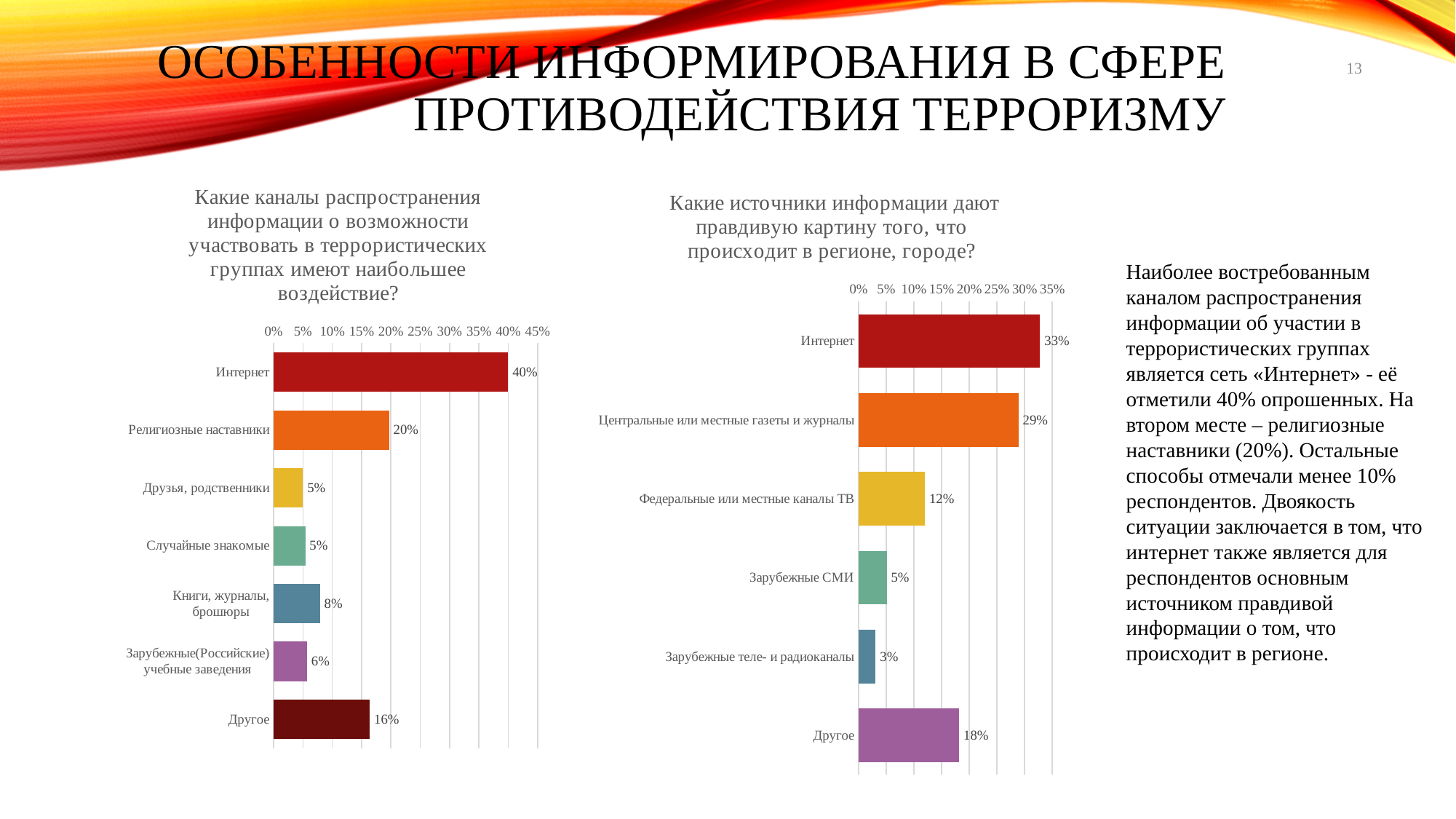
In the left chart (Какие каналы распространения информации...), what is the value for Интернет? 40% In the left chart (Какие каналы распространения информации...), what is the value for Религиозные наставники? 20% In the left chart (Какие каналы распространения информации...), which category has the lowest value? Друзья, родственники and Случайные знакомые (both 5%) What type of chart is used for the right chart (Какие источники информации дают правдивую картину...)? Bar chart In the right chart (Какие источники информации дают правдивую картину...), what is the difference between Федеральные или местные каналы ТВ and Зарубежные СМИ? 7% In the left chart (Какие каналы распространения информации...), what is the difference between Интернет and Другое? 24% In the right chart (Какие источники информации дают правдивую картину...), how many categories are shown? 6 In the left chart (Какие каналы распространения информации...), which is larger: Книги, журналы, брошюры or Зарубежные(Российские) учебные заведения? Книги, журналы, брошюры In the right chart (Какие источники информации дают правдивую картину...), what is the value for Центральные или местные газеты и журналы? 29% In the left chart (Какие каналы распространения информации...), how many categories are shown? 7 In the right chart (Какие источники информации дают правдивую картину...), which category has the highest value? Интернет In the right chart (Какие источники информации дают правдивую картину...), which category has the lowest value? Зарубежные теле- и радиоканалы